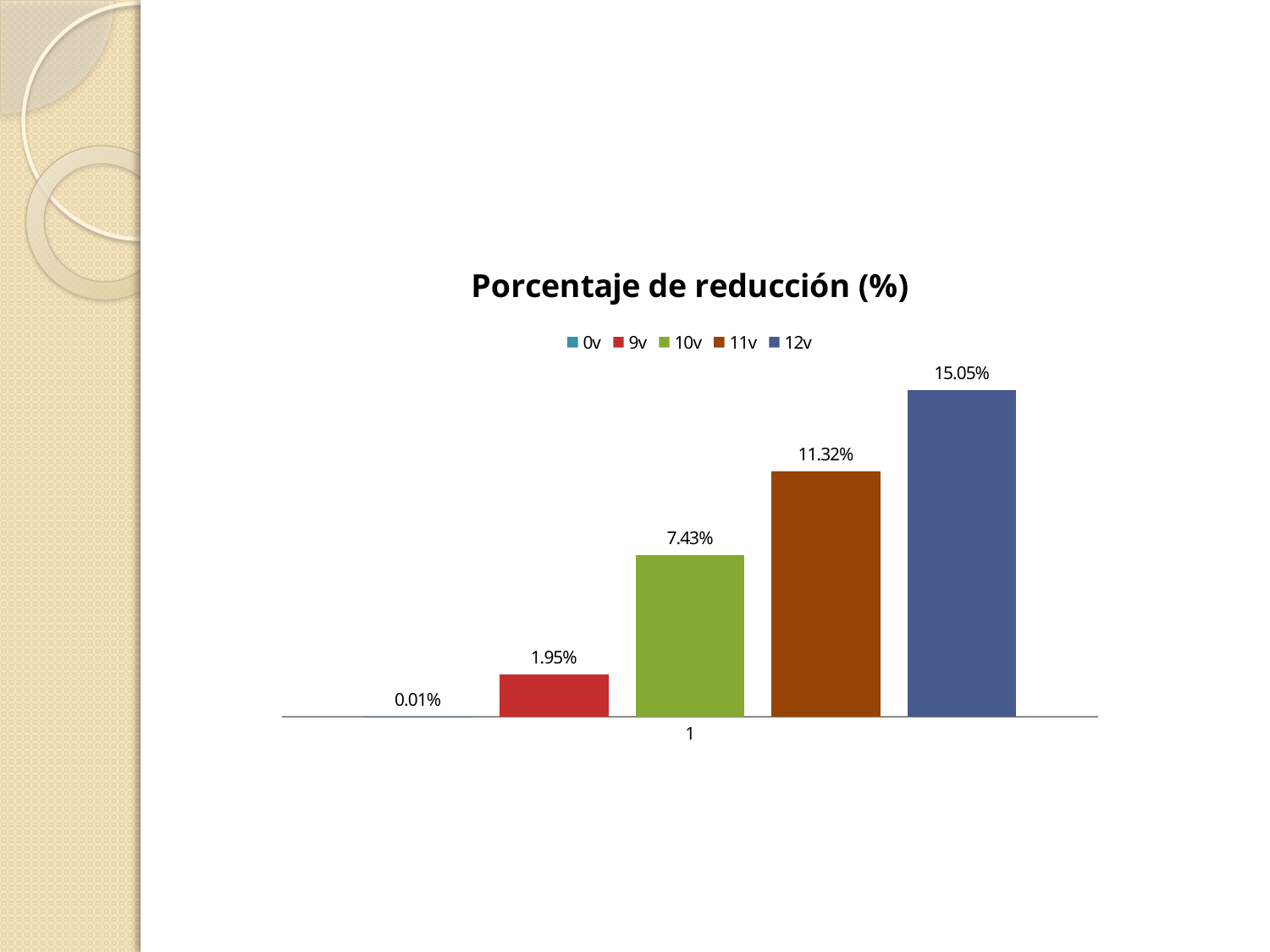
What is the difference between the values for 12v and 11v? 3.73% What is the title of the chart? Porcentaje de reducción (%) What is the value for 10v? 7.43% How many series does the legend list? 5 What is the value for 0v? 0.01% What is the value for 9v? 1.95% Do the values rise or fall from 0v to 12v? rise Which series has the highest value? 12v Which is larger, the value for 11v or the value for 10v? 11v What is the value for 12v? 15.05% Which series has the lowest value? 0v What kind of chart is shown on the slide? bar chart